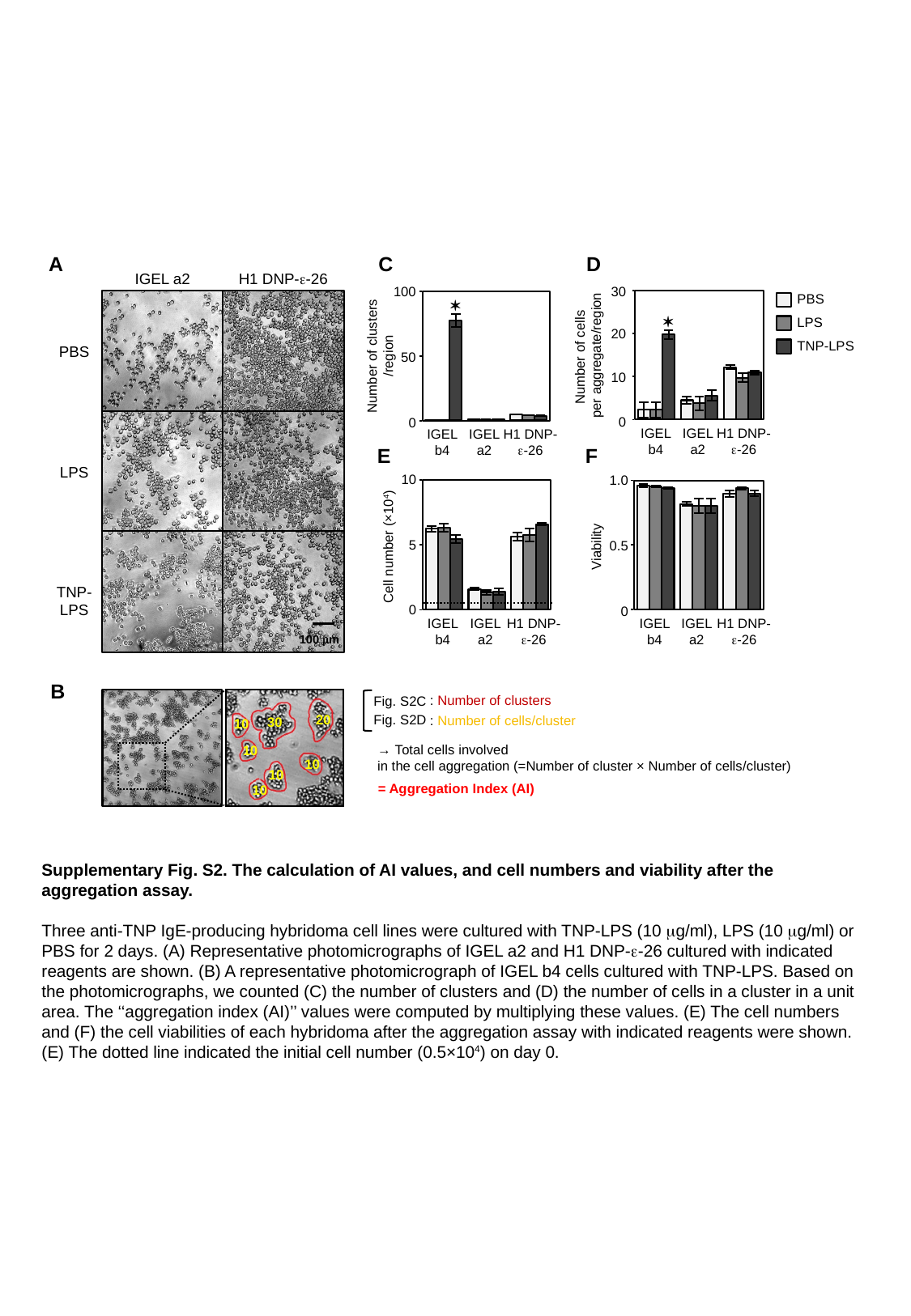
What are the three legend entries shown next to chart D? PBS, LPS, TNP-LPS In chart C (Number of clusters/region), which cell line has the highest number of clusters? IGEL b4 In chart E (Cell number), is the PBS value for IGEL a2 greater or less than 5? less In chart E (Cell number), which cell line has the lowest cell numbers? IGEL a2 In chart D (Number of cells per aggregate/region), is the TNP-LPS value for IGEL b4 greater or less than 10? greater How many cell line categories are shown on the x axis of chart C? 3 In chart E (Cell number), which is larger: the PBS value for IGEL b4 or the PBS value for IGEL a2? IGEL b4 In chart C (Number of clusters/region), is the TNP-LPS value for IGEL b4 greater or less than 50? greater How many series does the legend next to chart D list? 3 What kind of chart is chart C (Number of clusters/region)? bar chart